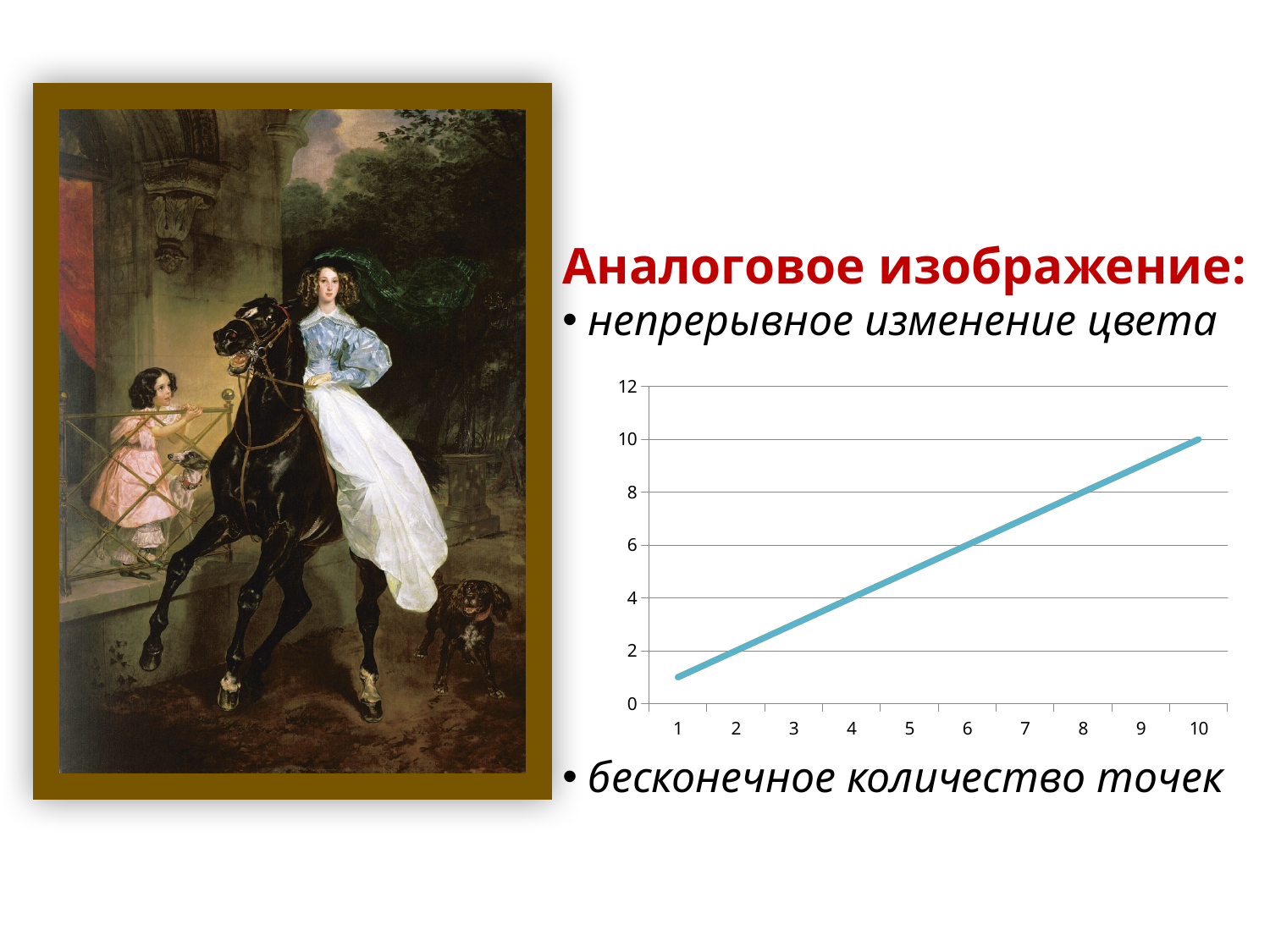
What is the highest value shown on the y axis of the chart? 12 At which x value does the line have its lowest point? 1 Is the value of the line at x = 3 greater or less than 4? less What kind of chart is shown on the slide? line chart Do the values on the chart rise or fall as x increases from 1 to 10? rise Which has the larger value on the line, x = 7 or x = 3? x = 7 How many points are labelled along the x axis of the chart? 10 Is the value of the line at x = 1 greater or less than 2? less Is the value of the line at x = 9 greater or less than 8? greater At which x value does the line reach its highest point? 10 What is the value of the line at x = 10? 10 What colour is the line on the chart? light blue